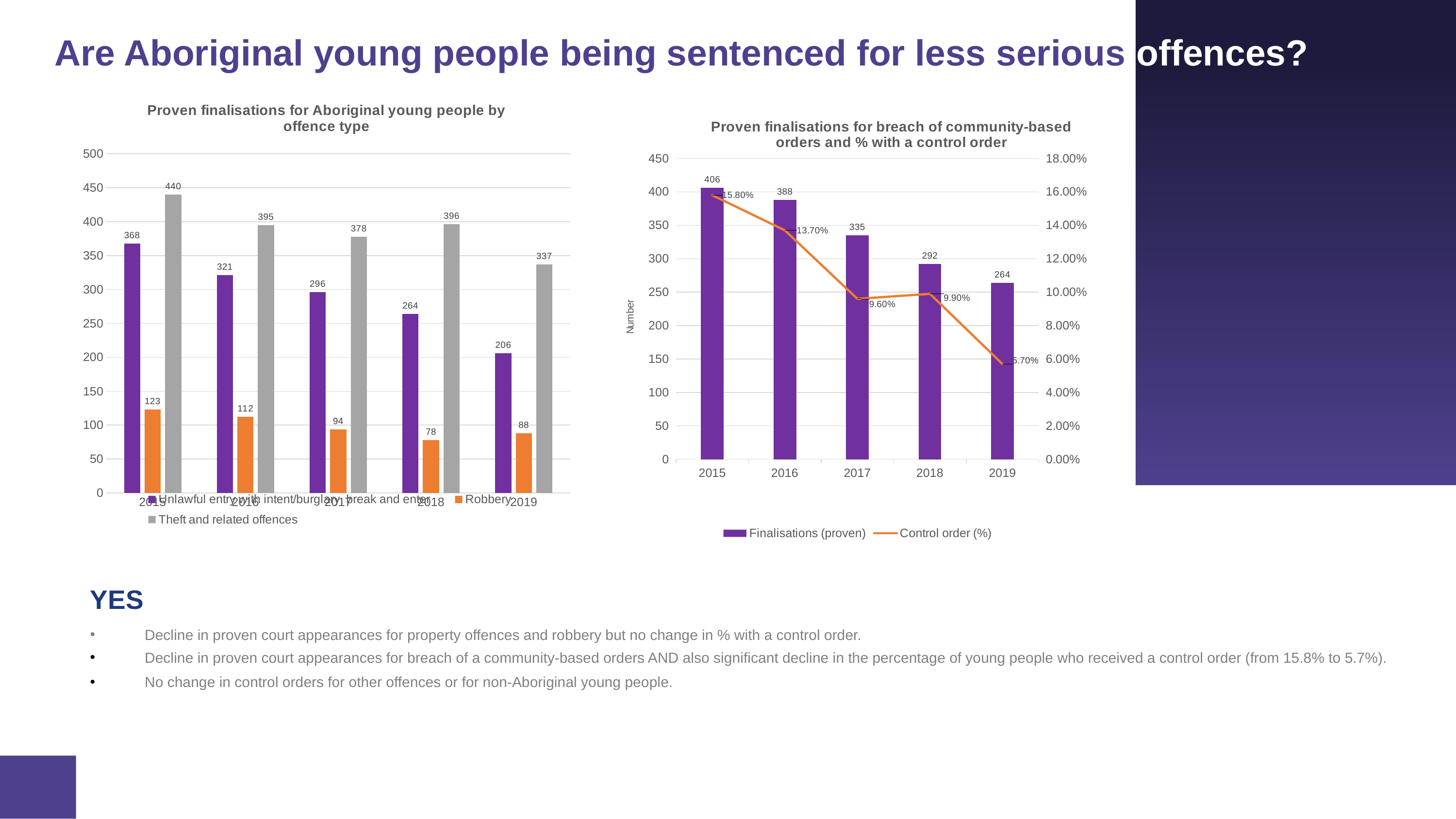
In the chart 'Proven finalisations for Aboriginal young people by offence type', what is the Robbery value for 2017? 94 In the chart 'Proven finalisations for Aboriginal young people by offence type', which year has the lowest value for Unlawful entry with intent/burglary, break and enter? 2019 In the chart 'Proven finalisations for breach of community-based orders and % with a control order', what is the Control order (%) value for 2019? 5.70% In the chart 'Proven finalisations for breach of community-based orders and % with a control order', what is the Finalisations (proven) value for 2017? 335 In the chart 'Proven finalisations for Aboriginal young people by offence type', what is the difference between the Theft and related offences values for 2015 and 2019? 103 In the chart 'Proven finalisations for breach of community-based orders and % with a control order', which is larger: the Control order (%) value for 2017 or for 2018? 2018 In the chart 'Proven finalisations for breach of community-based orders and % with a control order', which year has the highest Finalisations (proven) value? 2015 In the chart 'Proven finalisations for Aboriginal young people by offence type', is the Robbery value for 2018 greater or less than 100? less In the chart 'Proven finalisations for Aboriginal young people by offence type', how many series does the legend list? 3 In the chart 'Proven finalisations for breach of community-based orders and % with a control order', how do the Finalisations (proven) values change from 2015 to 2019? They fall In the chart 'Proven finalisations for Aboriginal young people by offence type', what is the value for Theft and related offences in 2015? 440 What type of chart is 'Proven finalisations for breach of community-based orders and % with a control order'? Combined bar and line chart